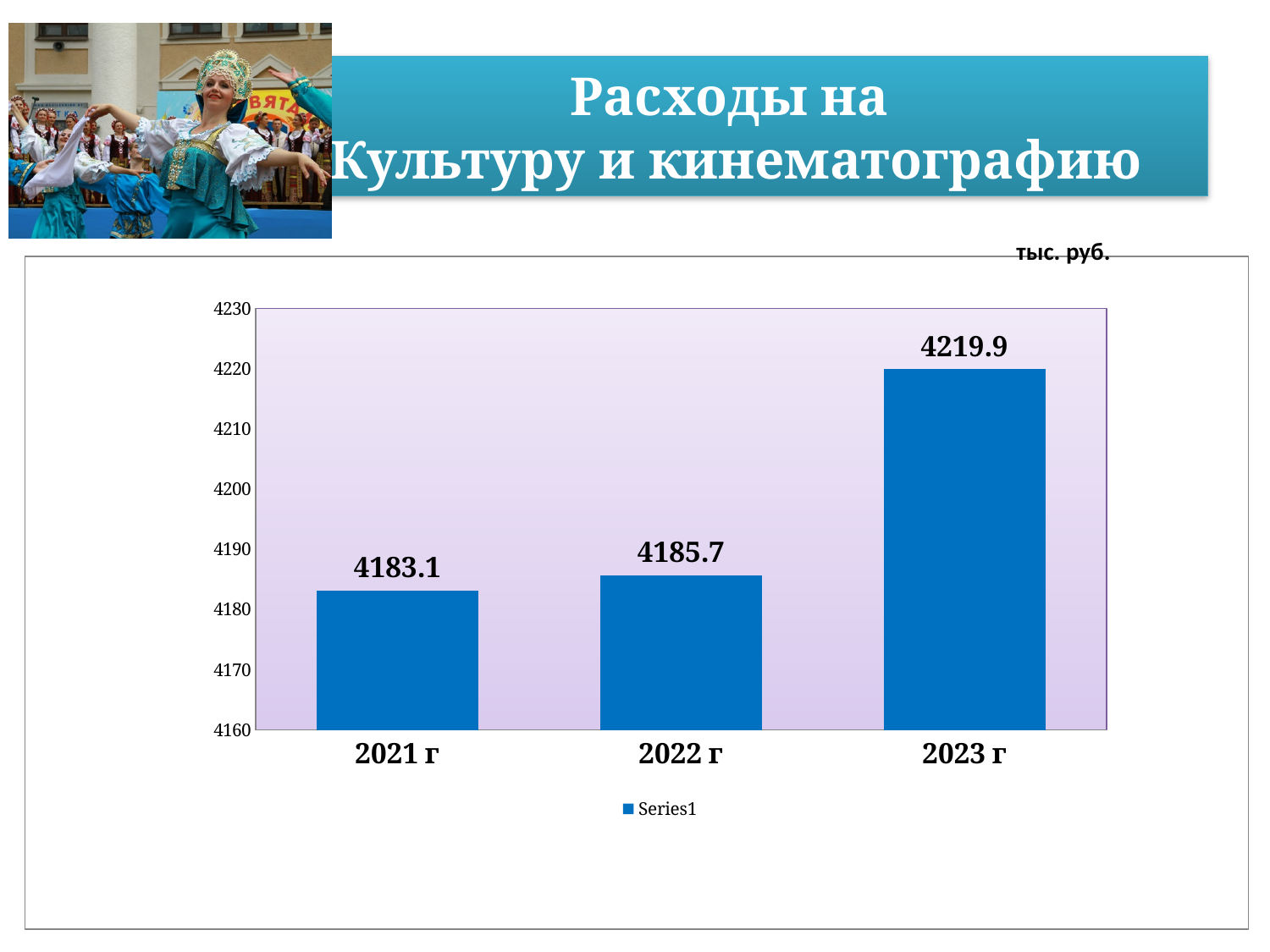
What kind of chart is shown on the slide? bar chart Do the values rise or fall from 2021 г to 2023 г? rise What is the value for 2021 г? 4183.1 What is the value for 2023 г? 4219.9 What is the value for 2022 г? 4185.7 What is the difference between the values for 2022 г and 2021 г? 2.6 Which year has the highest value? 2023 г Which year has the lowest value? 2021 г How many years are shown on the x axis? 3 Is the value for 2023 г greater or less than 4200? greater Which is larger, the value for 2021 г or the value for 2023 г? 2023 г What is the difference between the values for 2023 г and 2022 г? 34.2